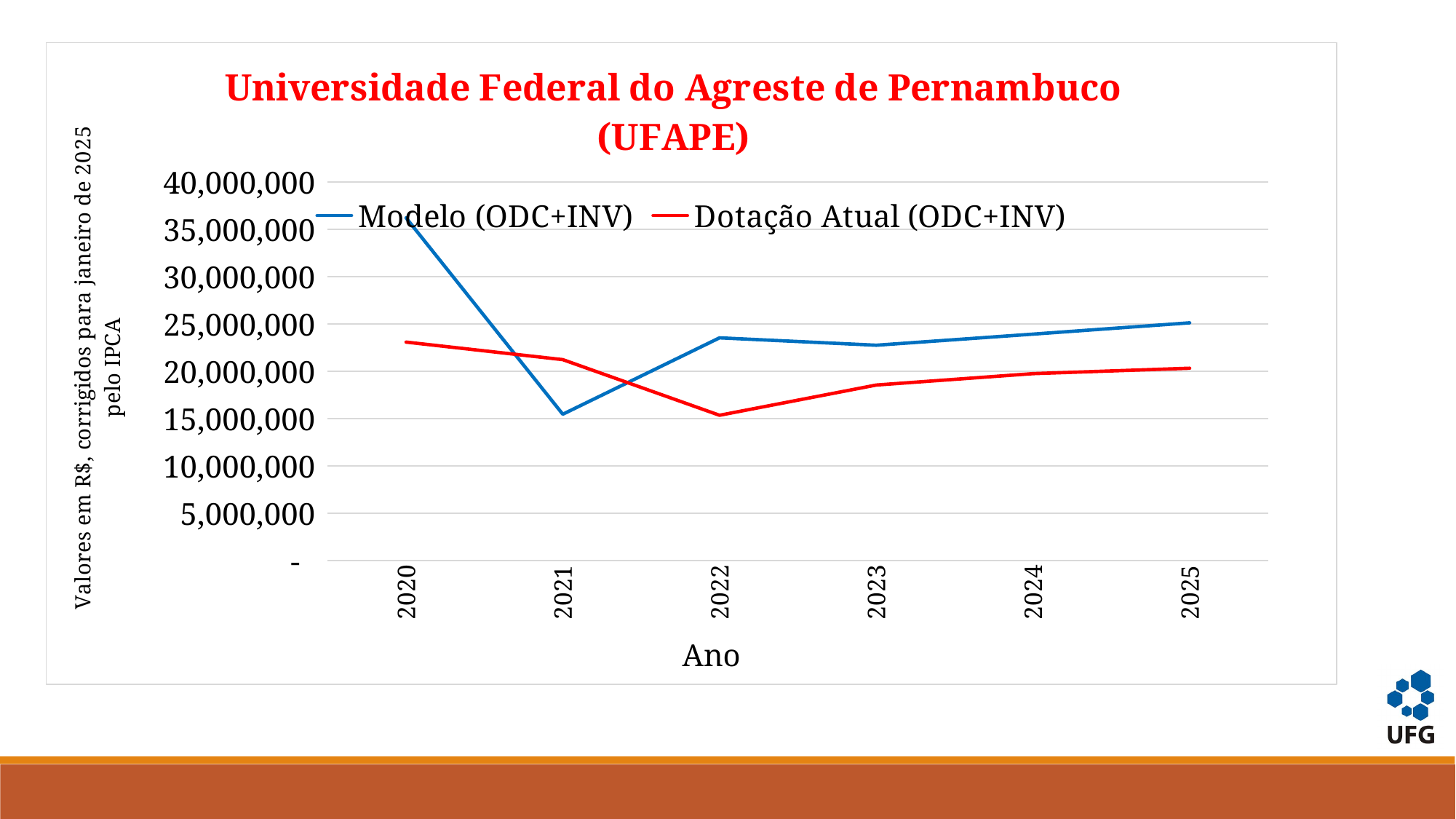
In which year is the Dotação Atual (ODC+INV) series at its highest? 2020 In 2025, which series has the larger value, Modelo (ODC+INV) or Dotação Atual (ODC+INV)? Modelo (ODC+INV) Is the value for Modelo (ODC+INV) in 2020 greater or less than 30,000,000? greater In which year is the Modelo (ODC+INV) series at its highest? 2020 In which year is the Dotação Atual (ODC+INV) series at its lowest? 2022 Does the Dotação Atual (ODC+INV) series rise or fall from 2022 to 2025? rise How many years are plotted along the x axis? 6 What kind of chart is shown on the slide? line chart How many series does the legend list? 2 In 2021, which series has the larger value, Modelo (ODC+INV) or Dotação Atual (ODC+INV)? Dotação Atual (ODC+INV) What colour is the line for Dotação Atual (ODC+INV)? red In which year is the Modelo (ODC+INV) series at its lowest? 2021